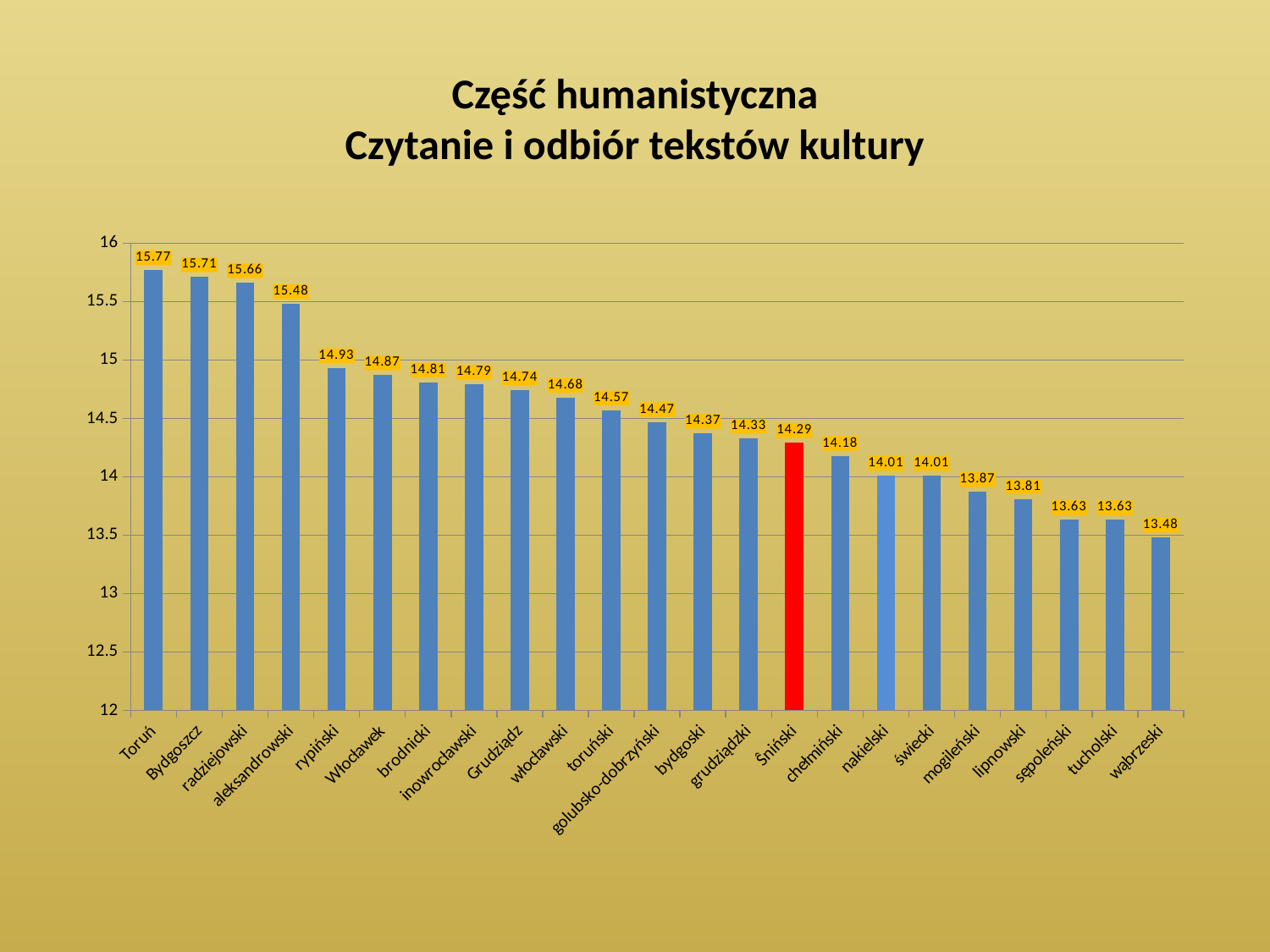
Is the value for aleksandrowski greater or less than 15? greater Do the values rise or fall from left to right along the x axis? fall What is the value for golubsko-dobrzyński? 14.47 How many categories are shown on the x axis? 23 Which category has the lowest value? wąbrzeski Which category has the highest value? Toruń What is the difference between the values for Toruń and wąbrzeski? 2.29 What kind of chart is shown on the slide? bar chart Which is larger, the value for rypiński or the value for chełmiński? rypiński What is the difference between the values for Bydgoszcz and Włocławek? 0.84 What is the value for Toruń? 15.77 What is the value for the red bar, żniński? 14.29